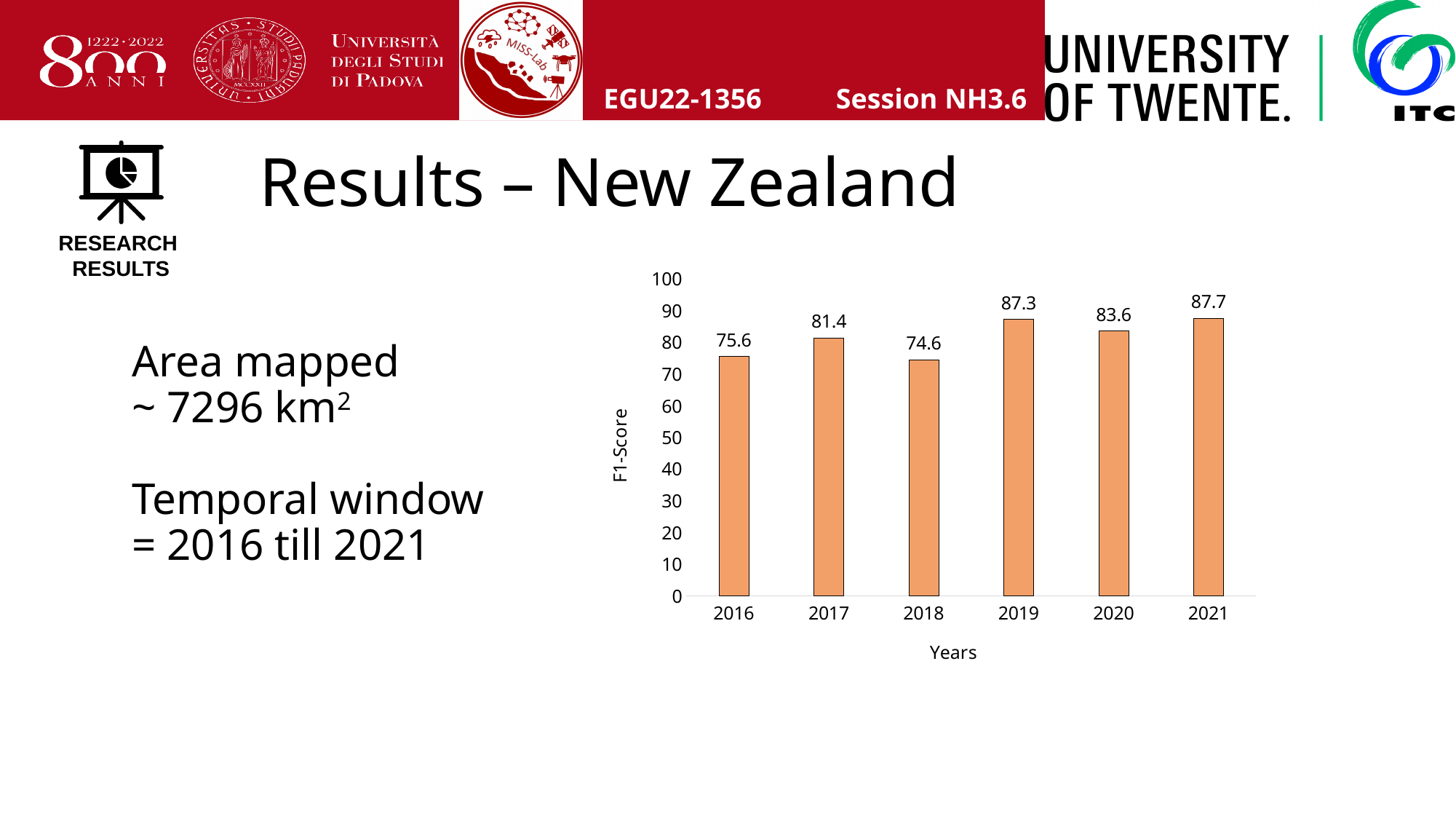
Which year has the highest F1-Score? 2021 How many years are shown on the x axis of the chart? 6 What is the difference between the F1-Score for 2017 and the F1-Score for 2016? 5.8 What is the F1-Score for 2016? 75.6 What kind of chart is shown on the slide? bar chart What is the difference between the F1-Score for 2019 and the F1-Score for 2018? 12.7 What is the F1-Score for 2019? 87.3 Is the F1-Score for 2018 greater or less than 80? less Which year has a higher F1-Score, 2017 or 2020? 2020 What is the F1-Score for 2021? 87.7 Which year has the lowest F1-Score? 2018 What is the label of the y axis of the chart? F1-Score